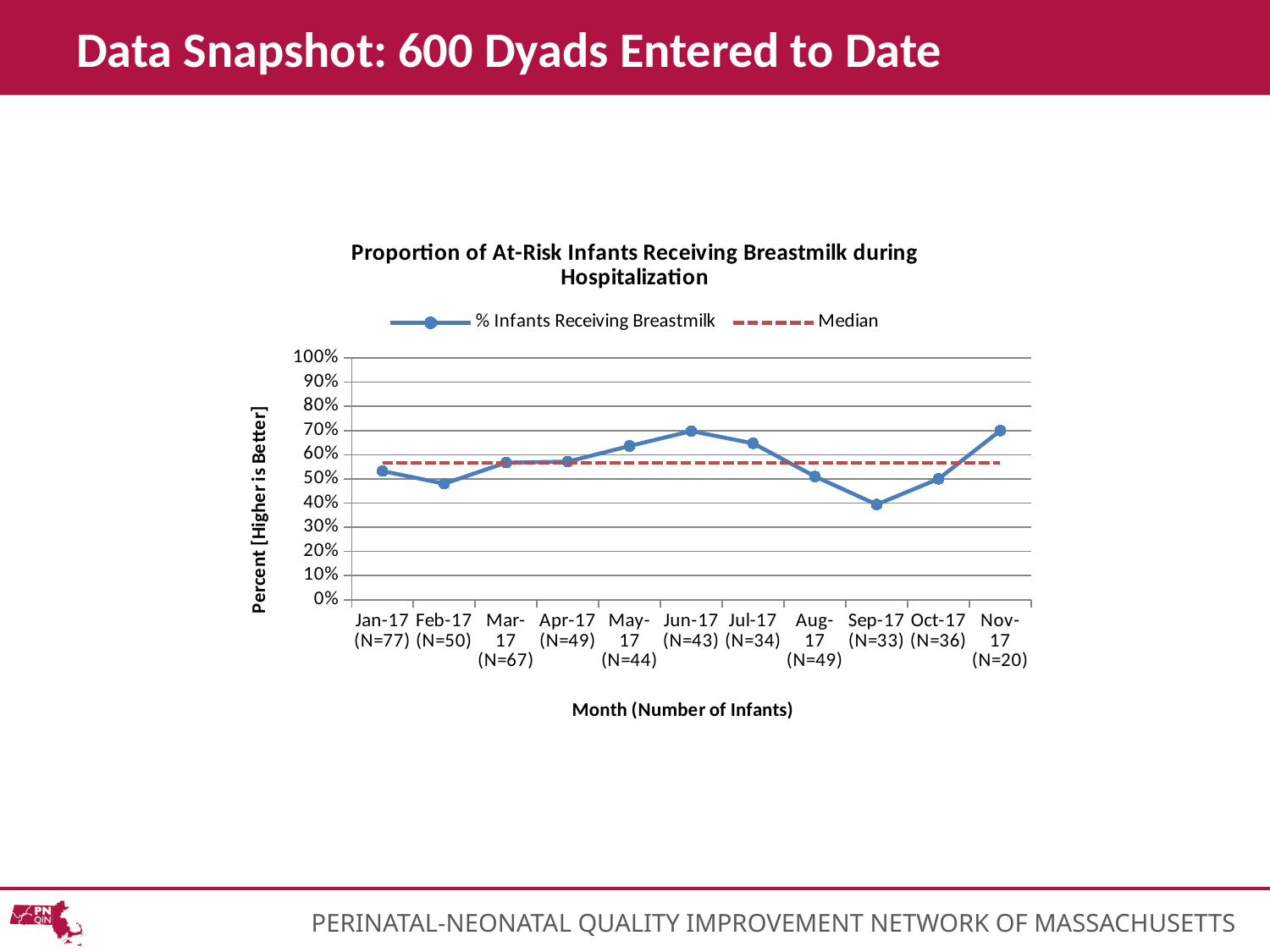
Do the values rise or fall from Jun-17 to Sep-17? fall Is the value for Jun-17 greater or less than 60%? greater What kind of chart is shown on the slide? line chart How many months are plotted on the x axis? 11 Is the value for Jul-17 greater or less than 60%? greater Is the value for Mar-17 greater or less than 50%? greater How many series does the legend list? 2 What is the label of the y axis? Percent [Higher is Better] What is the title of the chart? Proportion of At-Risk Infants Receiving Breastmilk during Hospitalization How many infants (N) are shown for Jan-17 on the x axis label? 77 Which month has the lowest percentage of infants receiving breastmilk? Sep-17